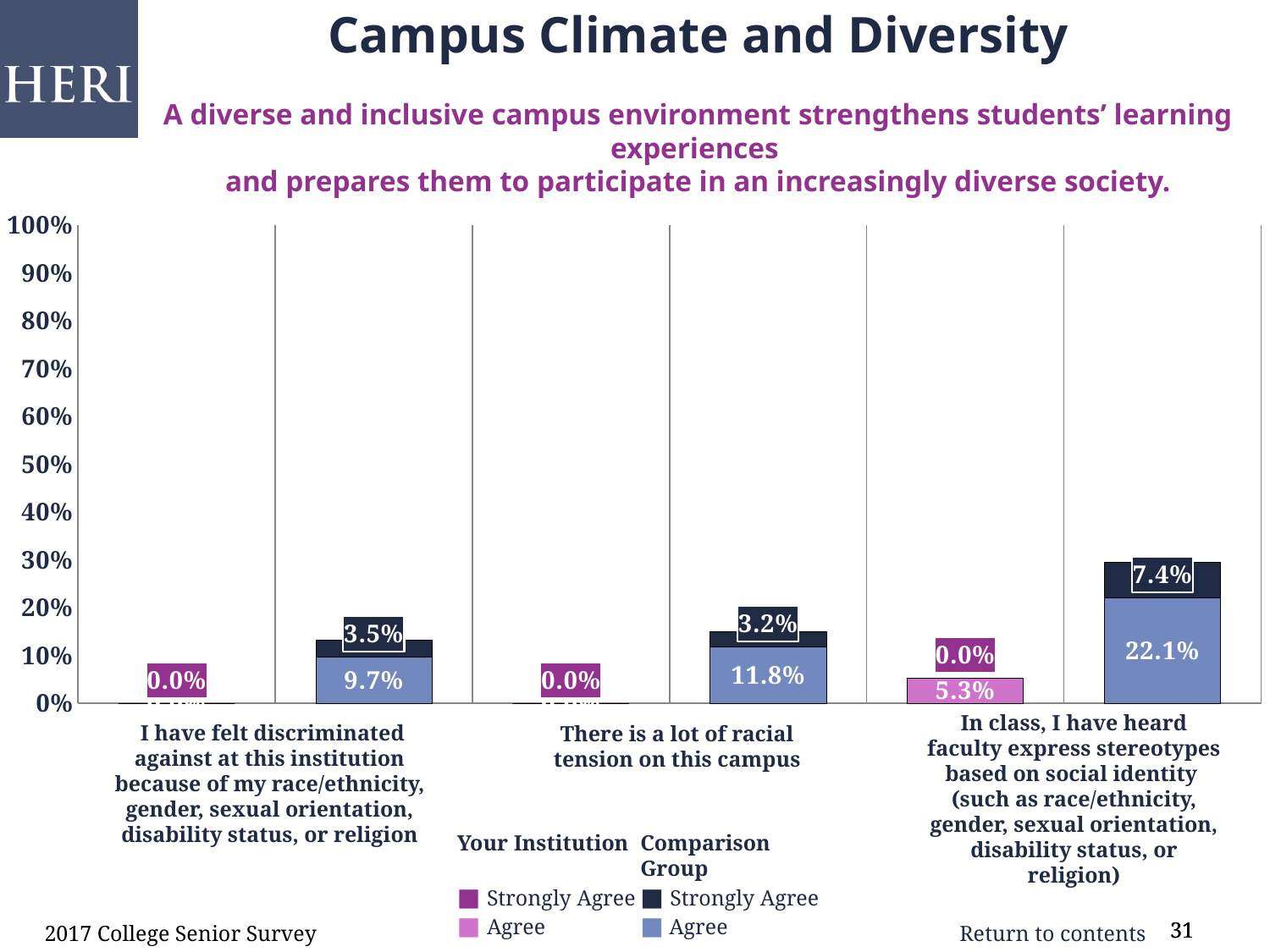
What is the Comparison Group 'Strongly Agree' value for 'In class, I have heard faculty express stereotypes based on social identity'? 7.4% What is the total of the Comparison Group stacked bar for 'There is a lot of racial tension on this campus'? 15.0% What is the Your Institution 'Agree' value for 'In class, I have heard faculty express stereotypes based on social identity'? 5.3% What is the Comparison Group 'Strongly Agree' value for 'I have felt discriminated against at this institution'? 3.5% How many survey statements (categories) are shown along the x axis? 3 What kind of chart is shown on the slide? Stacked bar chart What is the Comparison Group 'Agree' value for 'There is a lot of racial tension on this campus'? 11.8% Which statement has the highest Comparison Group 'Agree' value? In class, I have heard faculty express stereotypes based on social identity What is the total of the Comparison Group stacked bar for 'In class, I have heard faculty express stereotypes based on social identity'? 29.5% Is the Comparison Group 'Agree' value for 'There is a lot of racial tension on this campus' larger or smaller than the Comparison Group 'Agree' value for 'I have felt discriminated against at this institution'? Larger What is the difference between the Comparison Group 'Agree' values for 'In class, I have heard faculty express stereotypes' and 'I have felt discriminated against at this institution'? 12.4% How many series does the legend list? 4